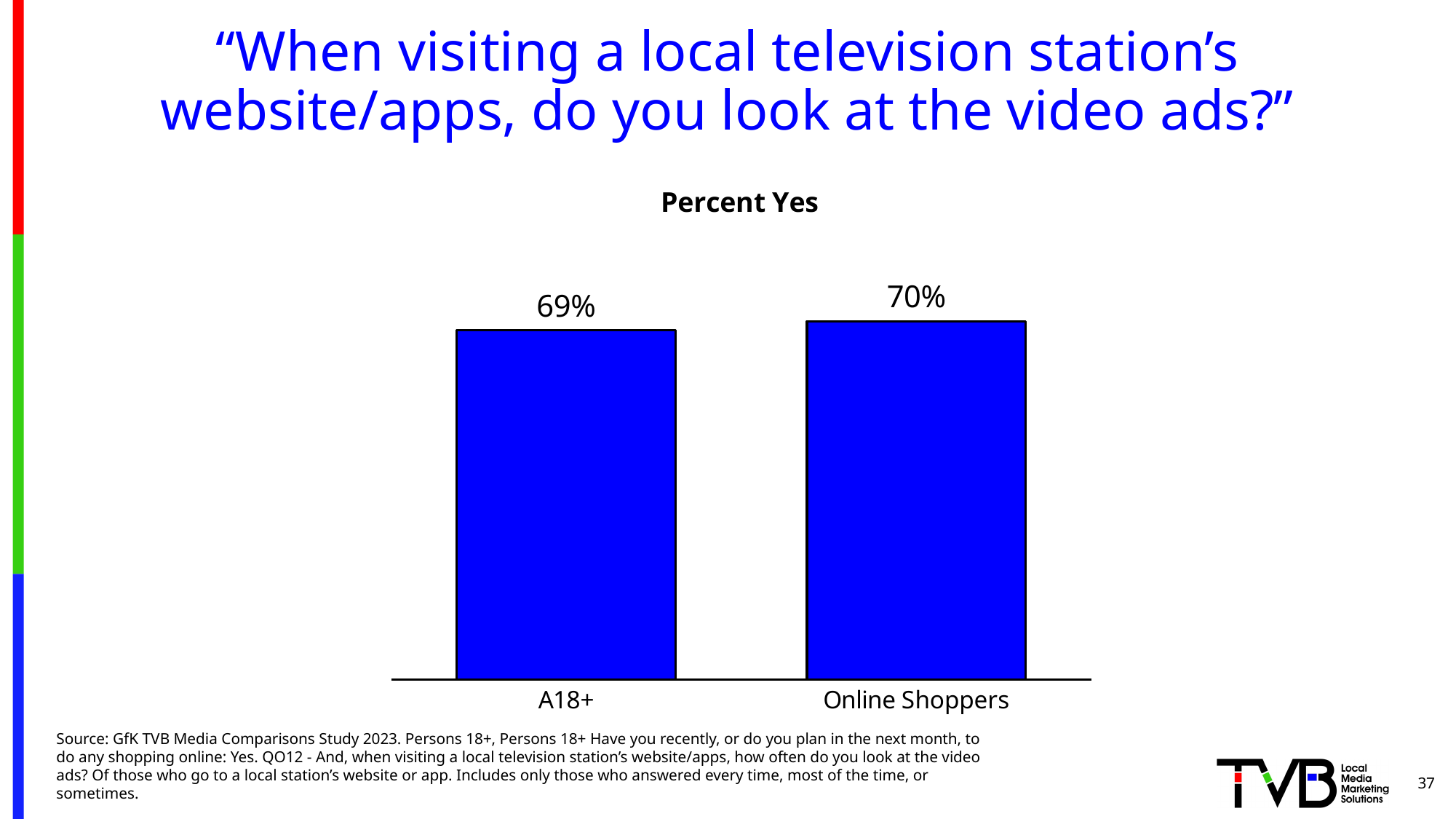
How many categories are shown in the chart? 2 What is the title of the chart? Percent Yes What colour are the bars in the chart? blue Which category has the higher Percent Yes value? Online Shoppers What is the difference in percentage points between the Online Shoppers value and the A18+ value? 1 percentage point What kind of chart is shown on the slide? bar chart Is the value for Online Shoppers larger or smaller than the value for A18+? larger Which category has the lower Percent Yes value? A18+ What is the Percent Yes value for Online Shoppers? 70% What is the Percent Yes value for A18+? 69%